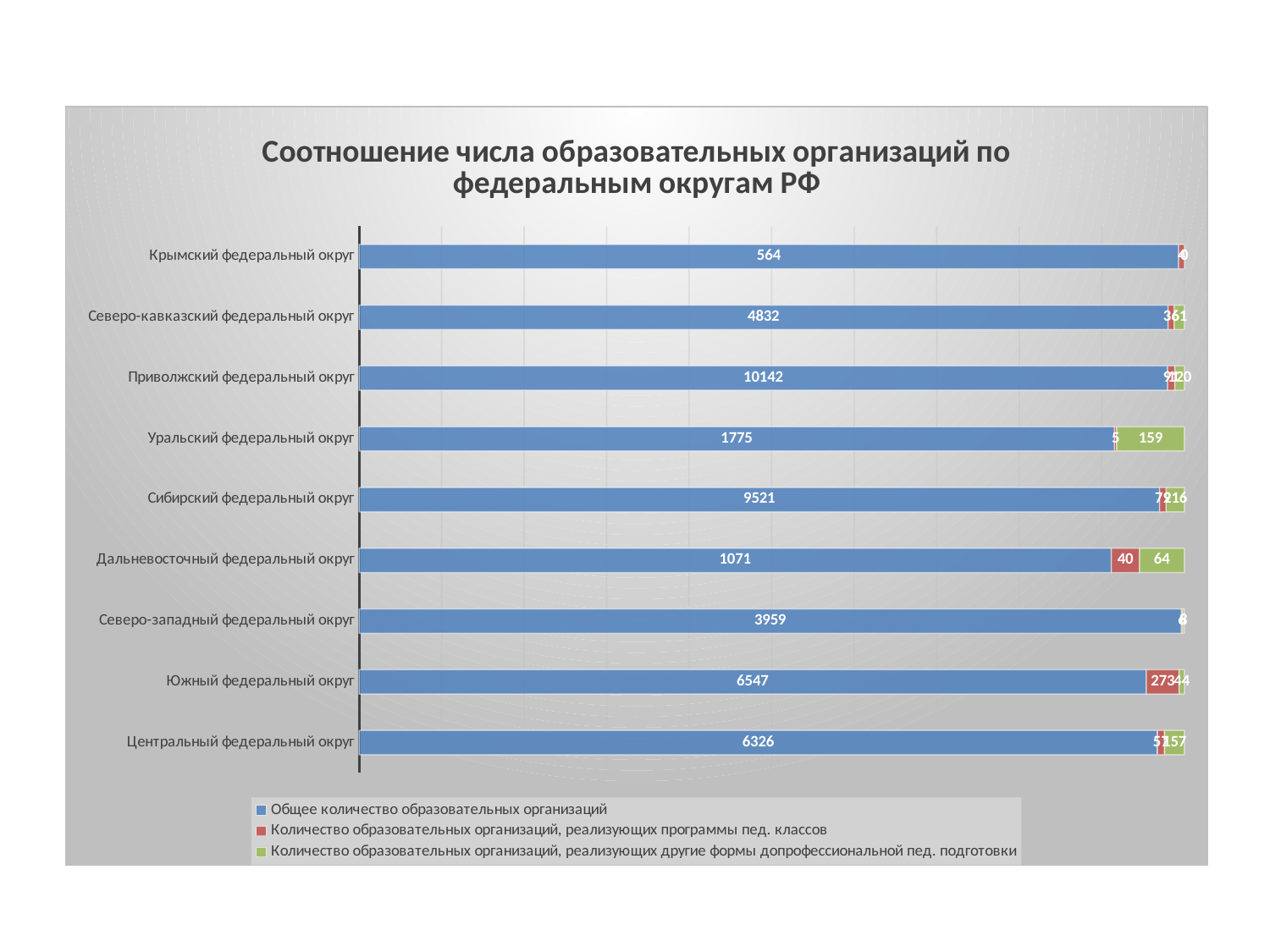
How many series does the legend list? 3 Which federal district has the lowest value for 'Общее количество образовательных организаций'? Крымский федеральный округ What is the value of 'Количество образовательных организаций, реализующих другие формы допрофессиональной пед. подготовки' for Уральский федеральный округ? 159 How many federal districts are shown on the chart? 9 What is the value of 'Количество образовательных организаций, реализующих программы пед. классов' for Дальневосточный федеральный округ? 40 What is the value of 'Общее количество образовательных организаций' for Приволжский федеральный округ? 10142 What kind of chart is shown on the slide? Bar chart Which has a larger 'Общее количество образовательных организаций' value: Южный федеральный округ or Центральный федеральный округ? Южный федеральный округ For Дальневосточный федеральный округ, what is the difference between the value for other forms of pre-professional pedagogical training (green) and the value for pedagogical class programmes (red)? 24 What is the value of 'Общее количество образовательных организаций' for Крымский федеральный округ? 564 What is the difference between the 'Общее количество образовательных организаций' values for Приволжский федеральный округ and Сибирский федеральный округ? 621 Which federal district has the highest value for 'Общее количество образовательных организаций'? Приволжский федеральный округ